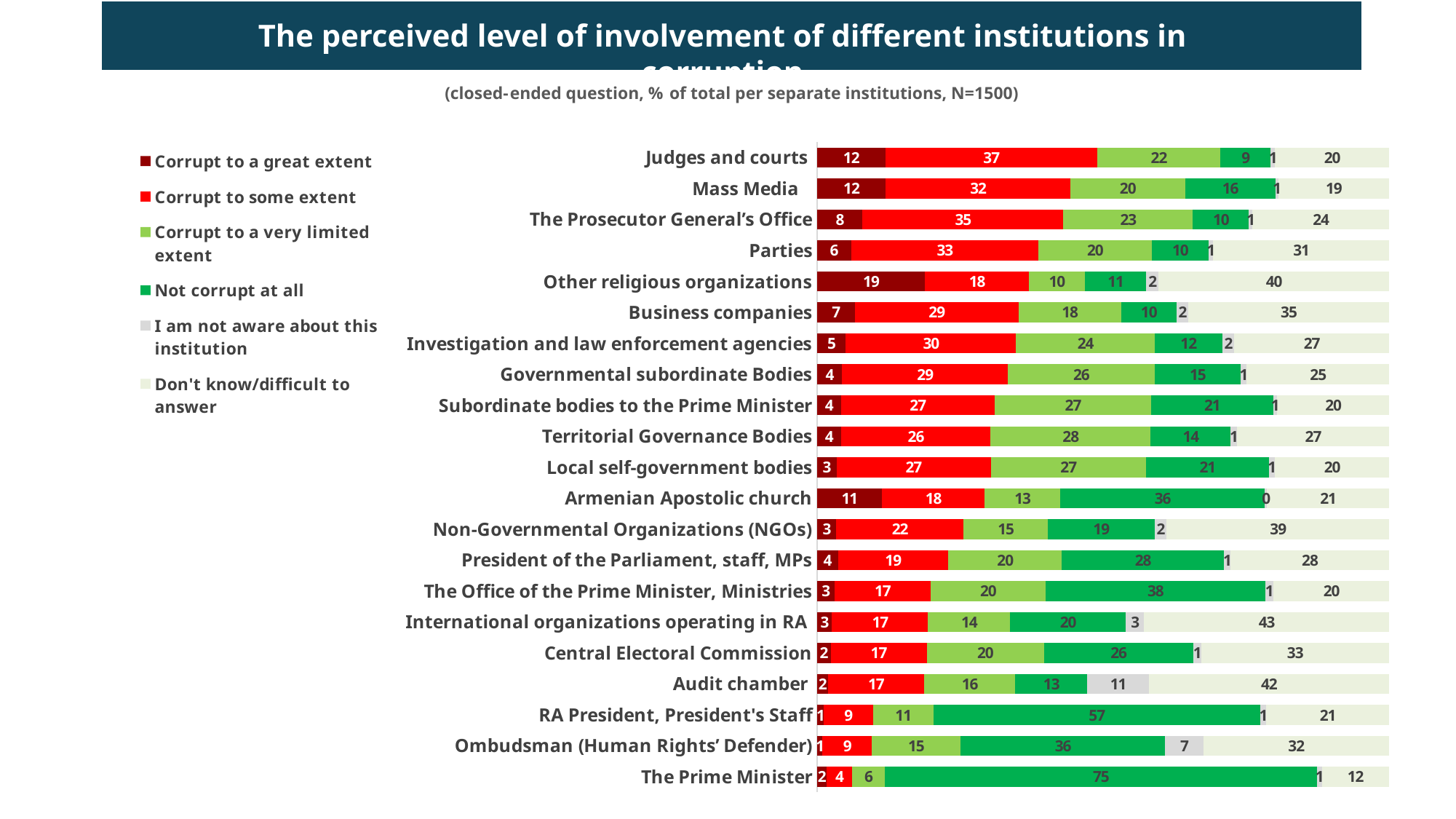
What is the value for 'I am not aware about this institution' for the Audit chamber? 11 Which institution has the lowest value for 'Don't know/difficult to answer'? The Prime Minister What kind of chart is shown on the slide? Stacked bar chart What is the difference between the 'Corrupt to some extent' values for Judges and courts and Mass Media? 5 How many series does the legend list? 6 What is the value for 'Corrupt to some extent' for Judges and courts? 37 Which has a larger 'Not corrupt at all' value: RA President, President's Staff or Armenian Apostolic church? RA President, President's Staff What is the sample size (N) stated in the chart subtitle? N=1500 How many institutions are plotted on the chart? 21 Which institution has the highest value for 'Not corrupt at all'? The Prime Minister Which institution has the highest value for 'Corrupt to a great extent'? Other religious organizations What is the value for 'Not corrupt at all' for the Ombudsman (Human Rights' Defender)? 36